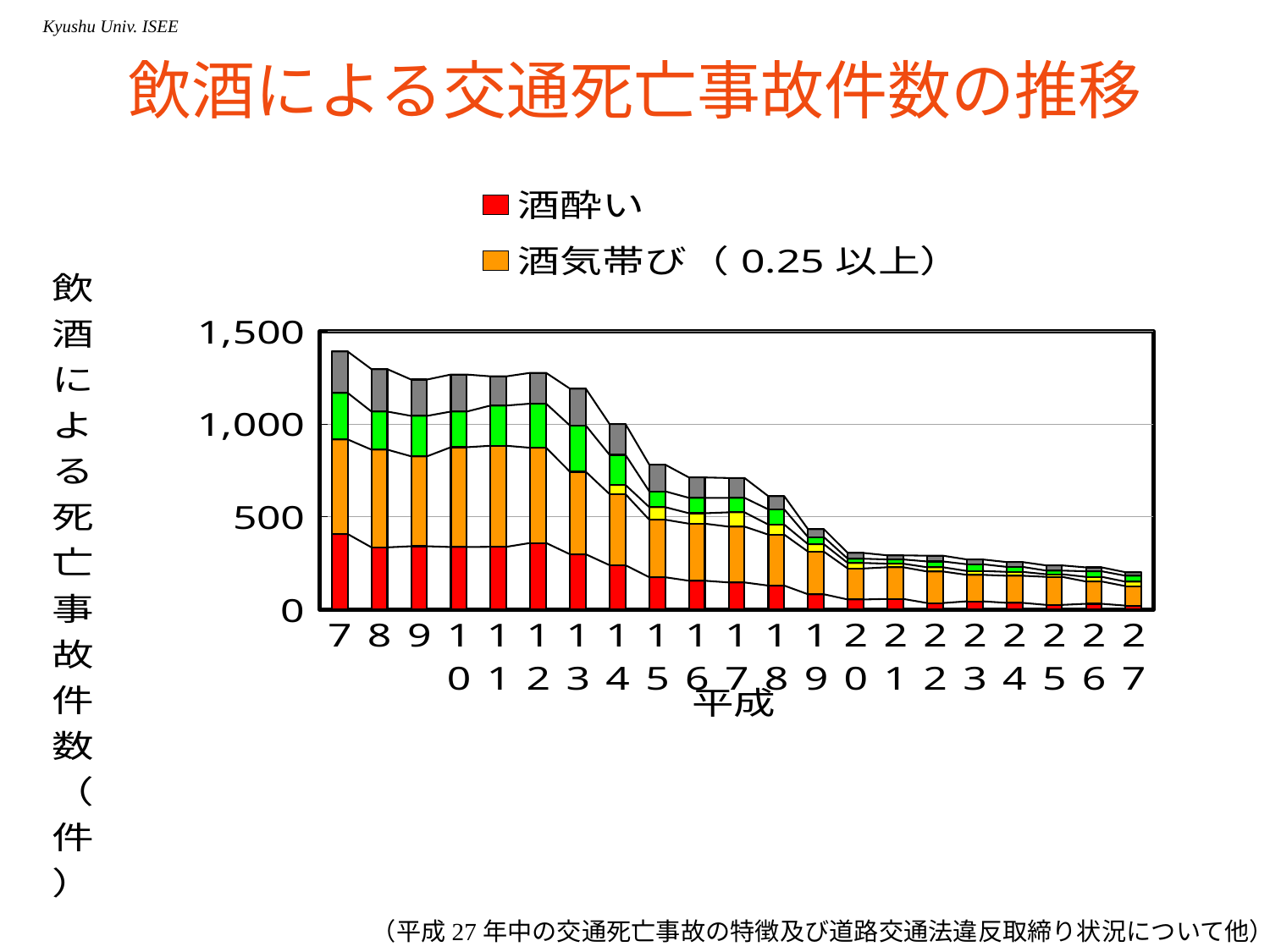
Is the total bar for 平成19 greater or less than 1,000? less How many years (categories) are plotted along the x axis? 21 Do the total bar heights generally rise or fall from 平成7 to 平成27? fall What is the title of the chart on the slide? 飲酒による交通死亡事故件数の推移 How many series does the chart's legend list? 2 Which has the larger total bar, 平成12 or 平成20? 平成12 Which colour represents 酒酔い in the legend? red Which year has the highest total bar? 平成7 What kind of chart is shown on the slide? stacked bar chart Is the total bar for 平成27 greater or less than 500? less Is the 酒酔い value for 平成7 greater or less than 500? less